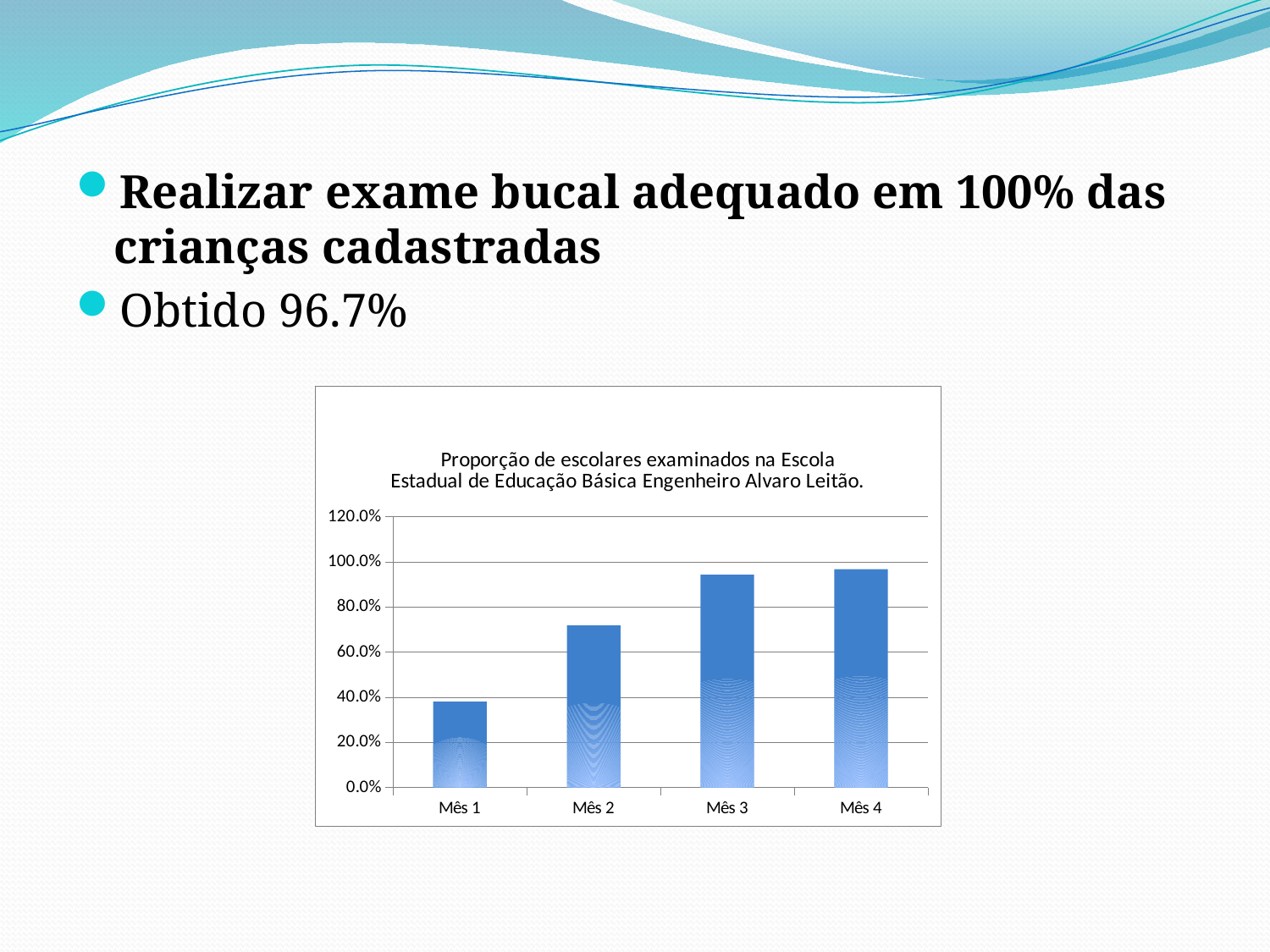
What is the title of the chart? Proporção de escolares examinados na Escola Estadual de Educação Básica Engenheiro Alvaro Leitão. Which is larger, the value for Mês 1 or the value for Mês 2? Mês 2 Do the values rise or fall from Mês 1 to Mês 4? rise Is the value for Mês 4 greater or less than 100.0%? less Is the value for Mês 1 greater or less than 20.0%? greater Is the value for Mês 3 greater or less than 80.0%? greater Which month has the lowest proportion of students examined? Mês 1 How many months (categories) are plotted on the chart? 4 Which is larger, the value for Mês 2 or the value for Mês 3? Mês 3 What kind of chart is shown on the slide? bar chart